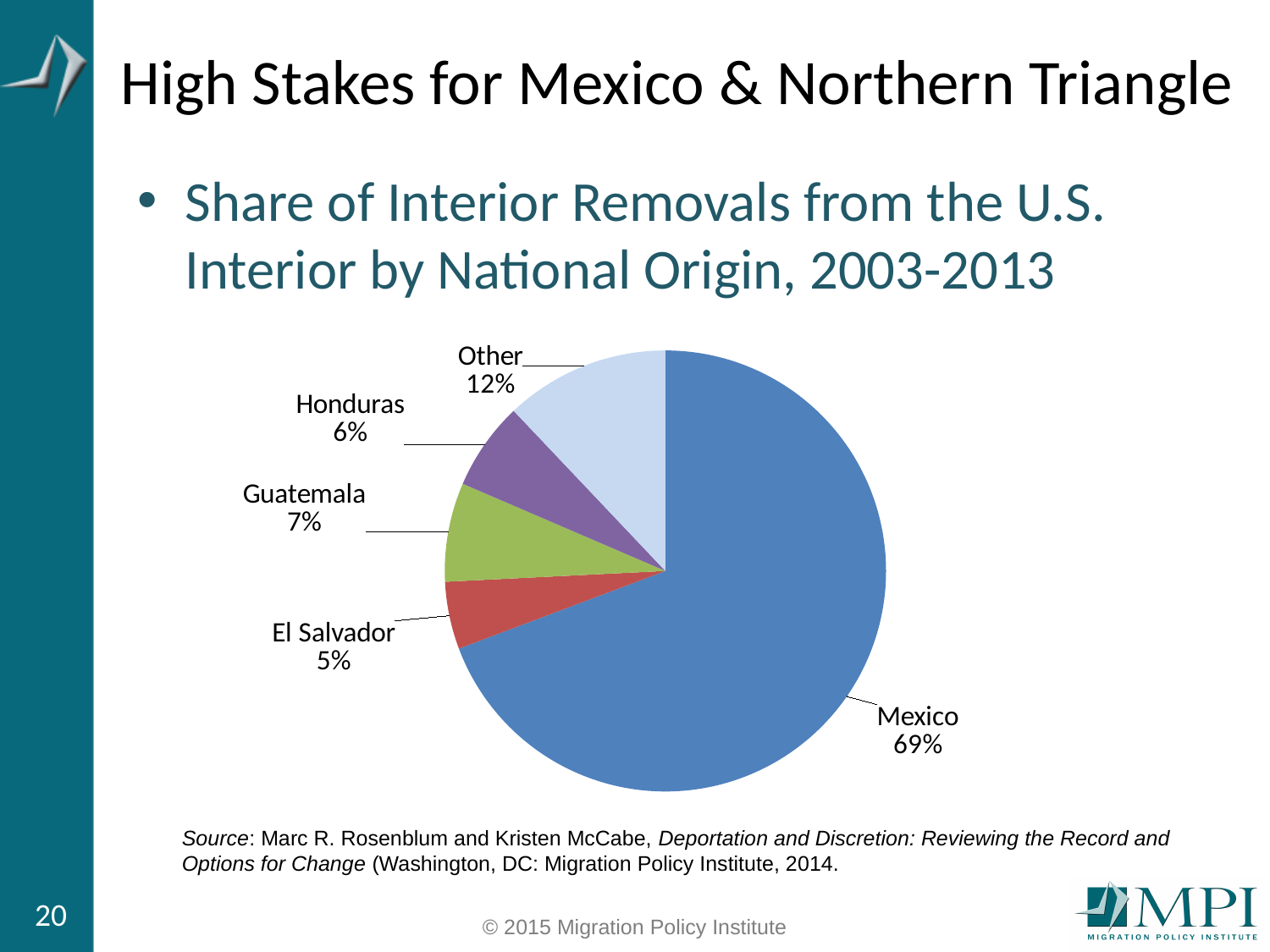
How many slices does the pie chart have? 5 What kind of chart is shown on the slide? Pie chart What share of interior removals is attributed to El Salvador? 5% What share of interior removals is attributed to Honduras? 6% Which has a larger share of interior removals, Guatemala or Honduras? Guatemala Which national origin has the smallest share of interior removals? El Salvador What share of interior removals is attributed to Guatemala? 7% What is the combined share of Guatemala, Honduras and El Salvador? 18% What share of interior removals is attributed to the Other category? 12% What share of interior removals is attributed to Mexico? 69% Which national origin has the largest share of interior removals? Mexico How many percentage points larger is Mexico's share than the Other category's share? 57